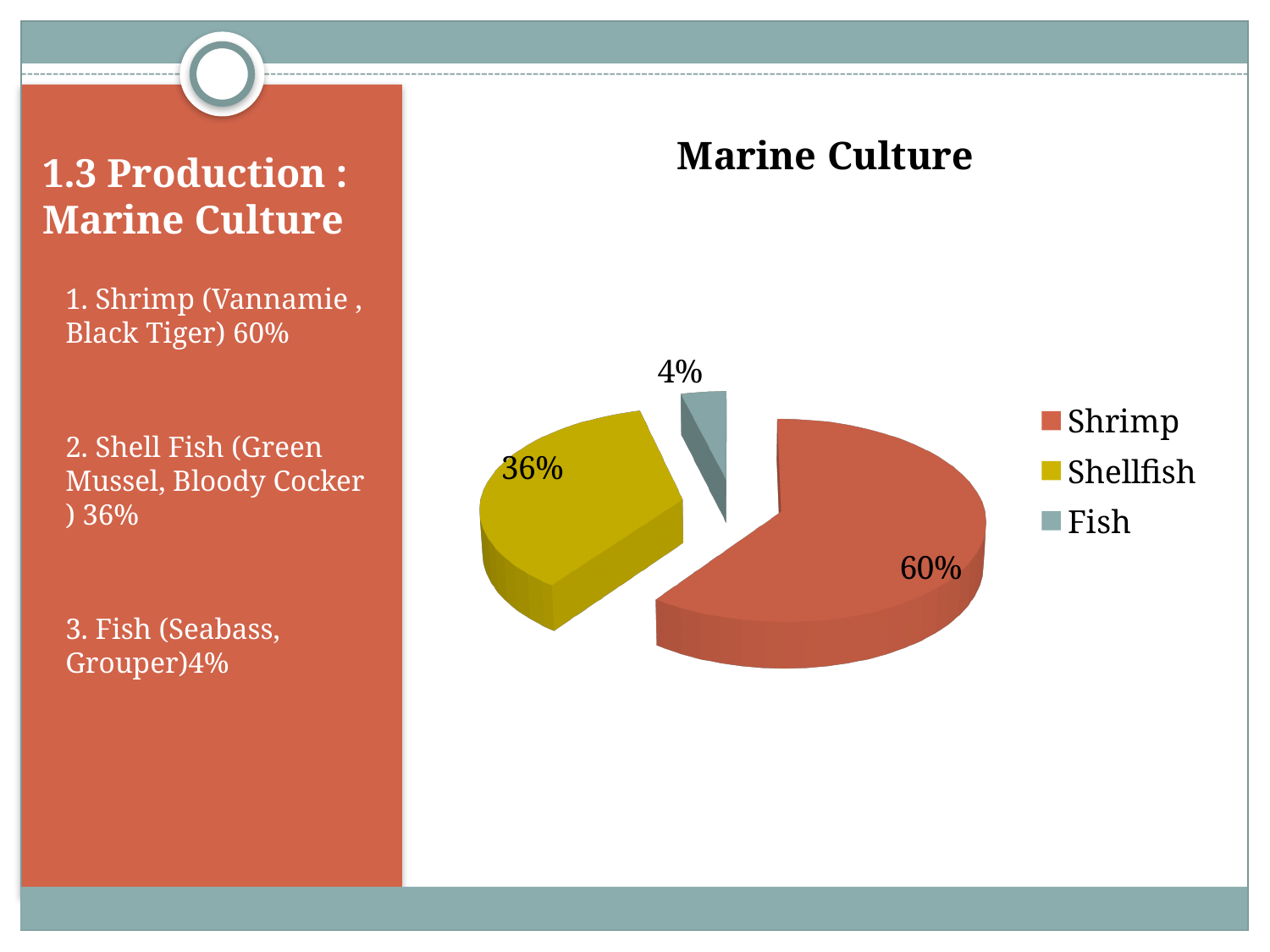
What share of the pie does Shrimp represent? 60% What is the difference in percentage points between the Shrimp and Shellfish slices? 24 Which category has the largest slice of the pie? Shrimp Which is larger, the Shellfish slice or the Fish slice? Shellfish What share of the pie does Shellfish represent? 36% Which category has the smallest slice of the pie? Fish What share of the pie does Fish represent? 4% What is the difference in percentage points between the Shellfish and Fish slices? 32 What is the title of the chart? Marine Culture Which colour represents Shellfish in the chart legend? Yellow What kind of chart is shown on the slide? Pie chart How many categories are shown in the pie chart? 3